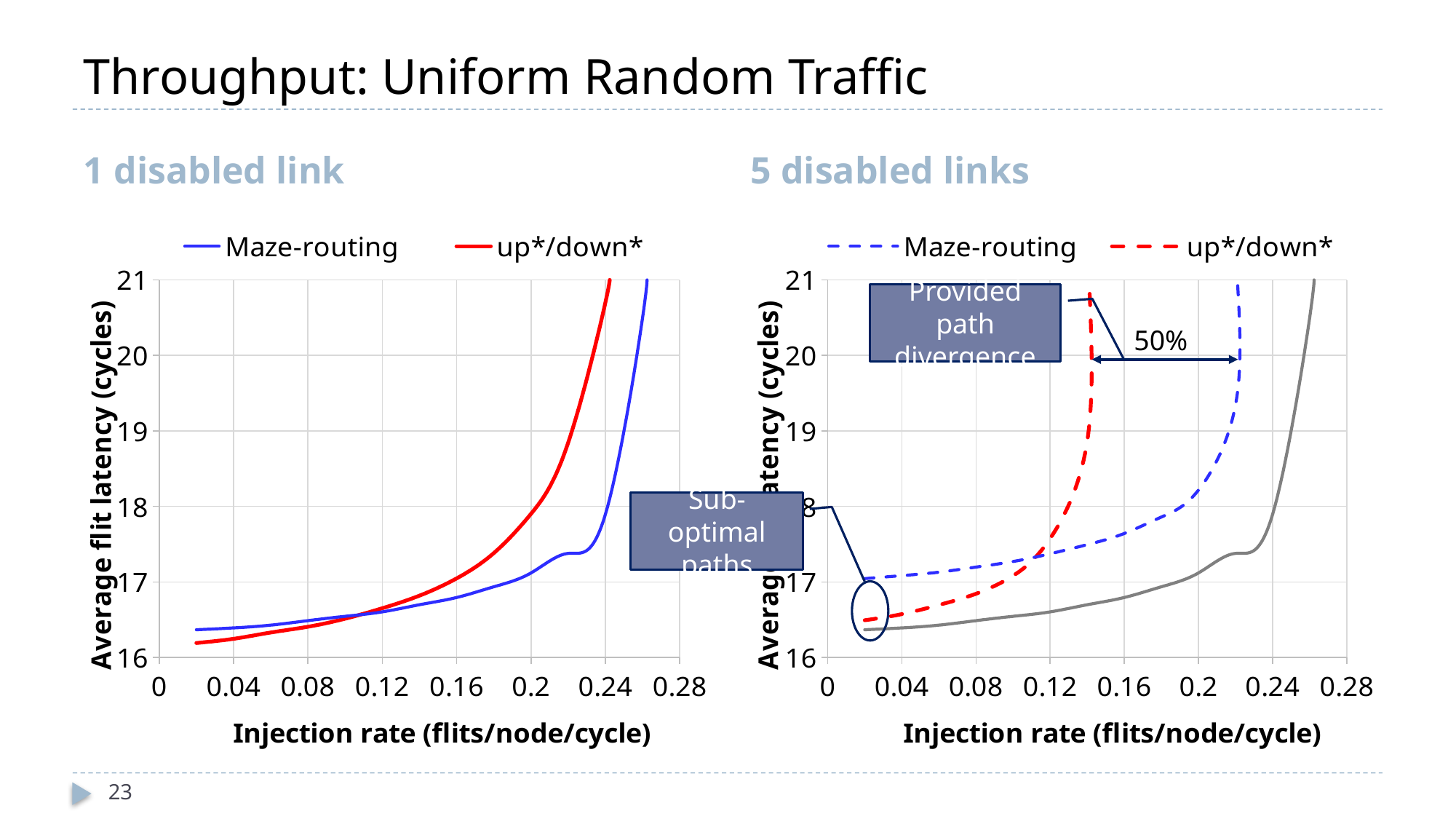
In the '5 disabled links' chart, is the up*/down* value at an injection rate of 0.12 greater or less than 17? greater What percentage is shown in the annotation between the two dashed curves in the '5 disabled links' chart? 50% What is the x-axis title of the '1 disabled link' chart? Injection rate (flits/node/cycle) What kind of chart is the '1 disabled link' chart? line chart In the '5 disabled links' chart, which series reaches a latency of 21 cycles at the lower injection rate? up*/down* In the '1 disabled link' chart, is the up*/down* value at an injection rate of 0.22 greater or less than 18? greater How many series does the legend of the '1 disabled link' chart list? 2 How many series does the legend of the '5 disabled links' chart list? 2 In the '1 disabled link' chart, is the Maze-routing value at an injection rate of 0.12 greater or less than 17? less In the '1 disabled link' chart, does the average flit latency for up*/down* rise or fall as the injection rate increases? rise In the '1 disabled link' chart, which series has the higher average flit latency at an injection rate of 0.2? up*/down*